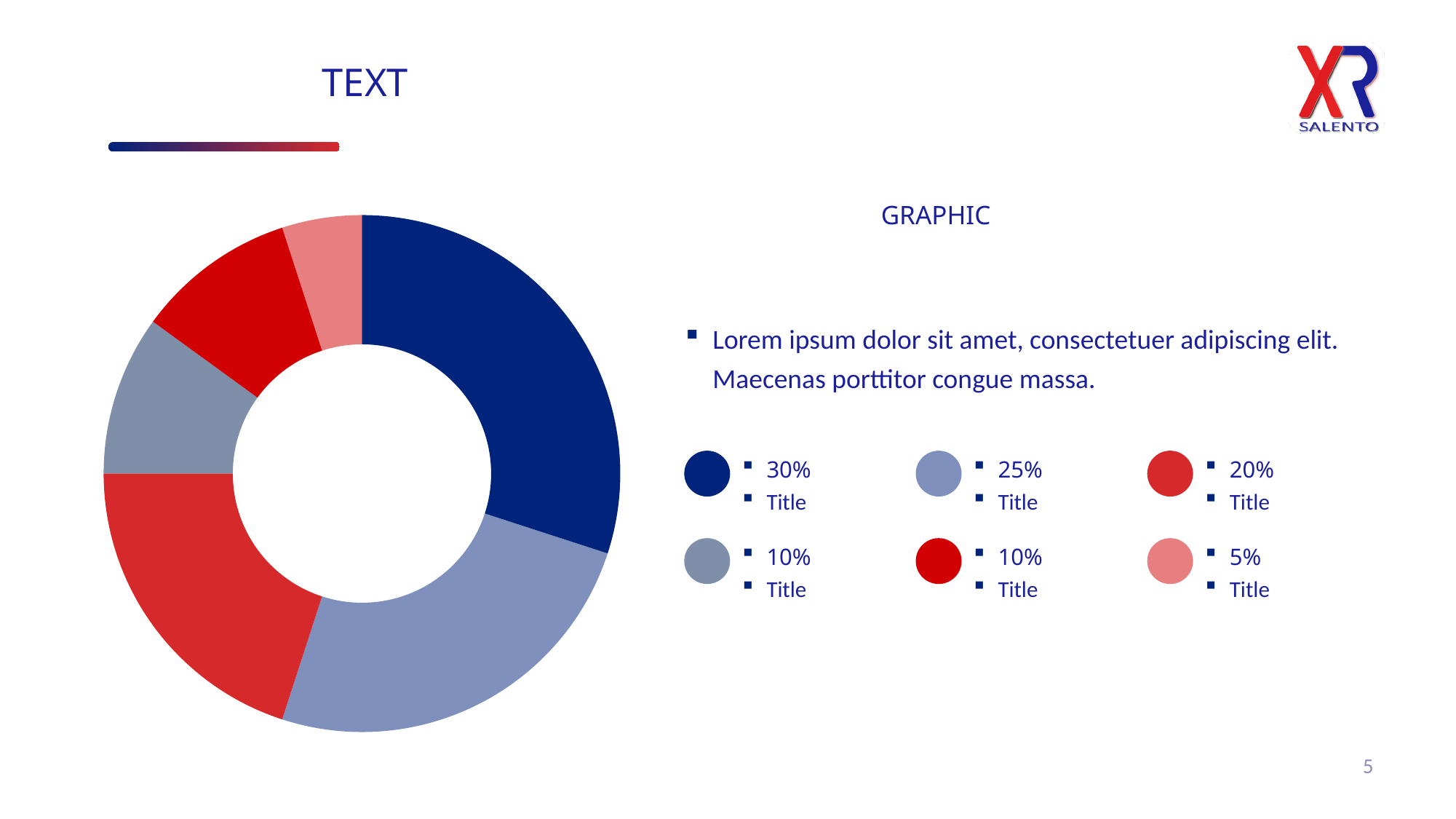
How many slices does the donut chart have? 6 Which colour slice is the largest in the donut chart? Dark blue Which is larger, the light blue slice or the red slice? Light blue What is the combined share of the dark blue and light blue slices? 55% What is the difference between the dark blue slice (30%) and the red slice (20%)? 10% What percentage does the dark blue slice of the donut chart represent? 30% What is the heading shown above the legend on the right side of the slide? GRAPHIC What percentage does the pink slice of the donut chart represent? 5% What percentage does the gray slice of the donut chart represent? 10% What percentage does the light blue slice of the donut chart represent? 25% What kind of chart is shown on the slide? Donut chart Which colour slice is the smallest in the donut chart? Pink